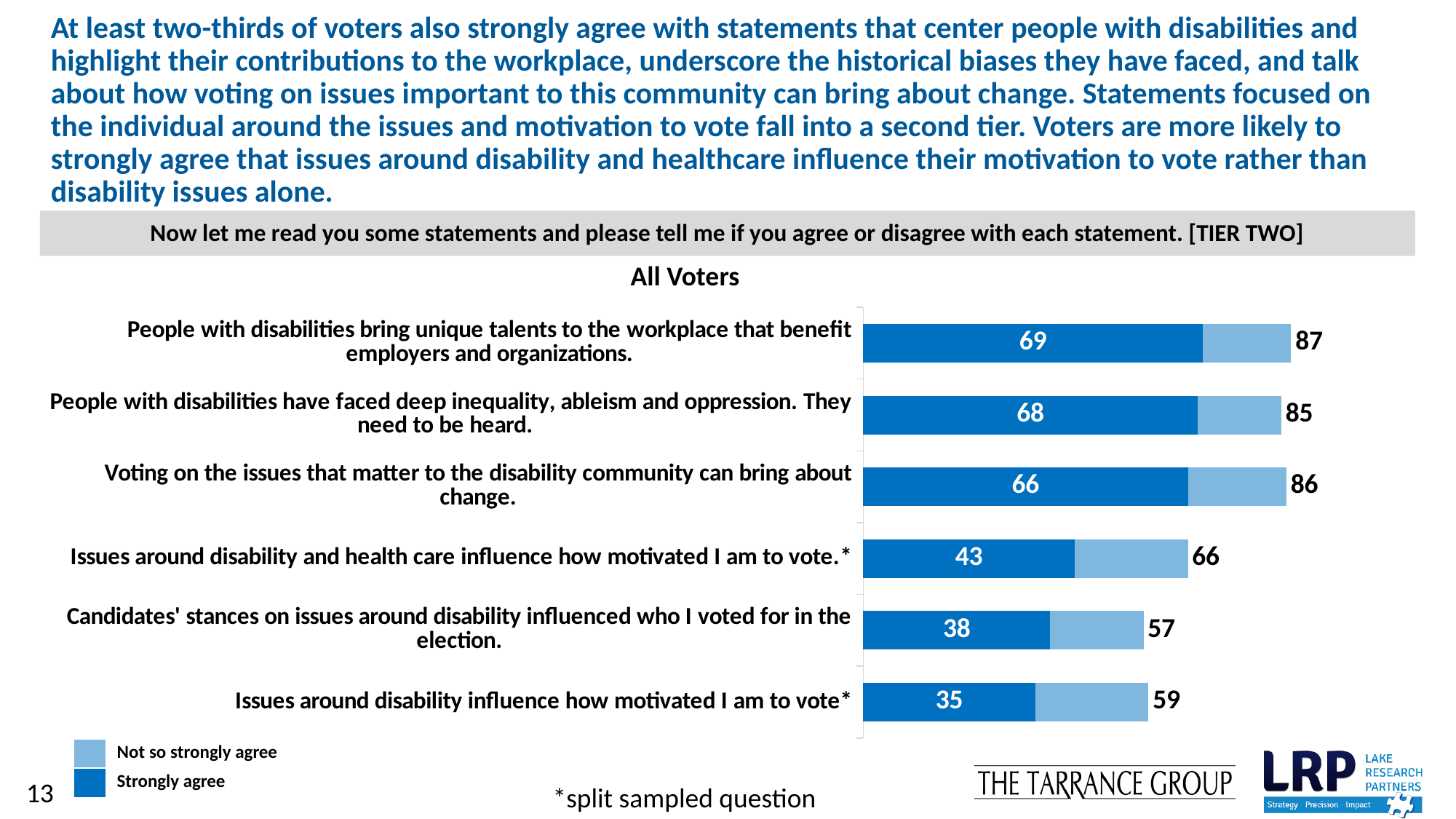
What is the difference between the 'Strongly agree' values for 'Issues around disability and health care influence how motivated I am to vote.*' and 'Issues around disability influence how motivated I am to vote*'? 8 What is the total agreement shown for the statement 'Voting on the issues that matter to the disability community can bring about change.'? 86 Which legend entry is shown in the darker blue colour? Strongly agree What is the 'Strongly agree' value for 'Issues around disability influence how motivated I am to vote*'? 35 Which statement has the lowest 'Strongly agree' value? Issues around disability influence how motivated I am to vote* How many statements are shown in the chart? 6 Which has a higher total agreement: 'Candidates' stances on issues around disability influenced who I voted for in the election.' or 'Issues around disability influence how motivated I am to vote*'? Issues around disability influence how motivated I am to vote* How many series does the legend list? 2 What is the 'Strongly agree' value for the statement 'People with disabilities bring unique talents to the workplace that benefit employers and organizations.'? 69 What kind of chart is shown on the slide? Stacked bar chart Which statement has the highest 'Strongly agree' value? People with disabilities bring unique talents to the workplace that benefit employers and organizations. What is the total agreement for 'Candidates' stances on issues around disability influenced who I voted for in the election.'? 57